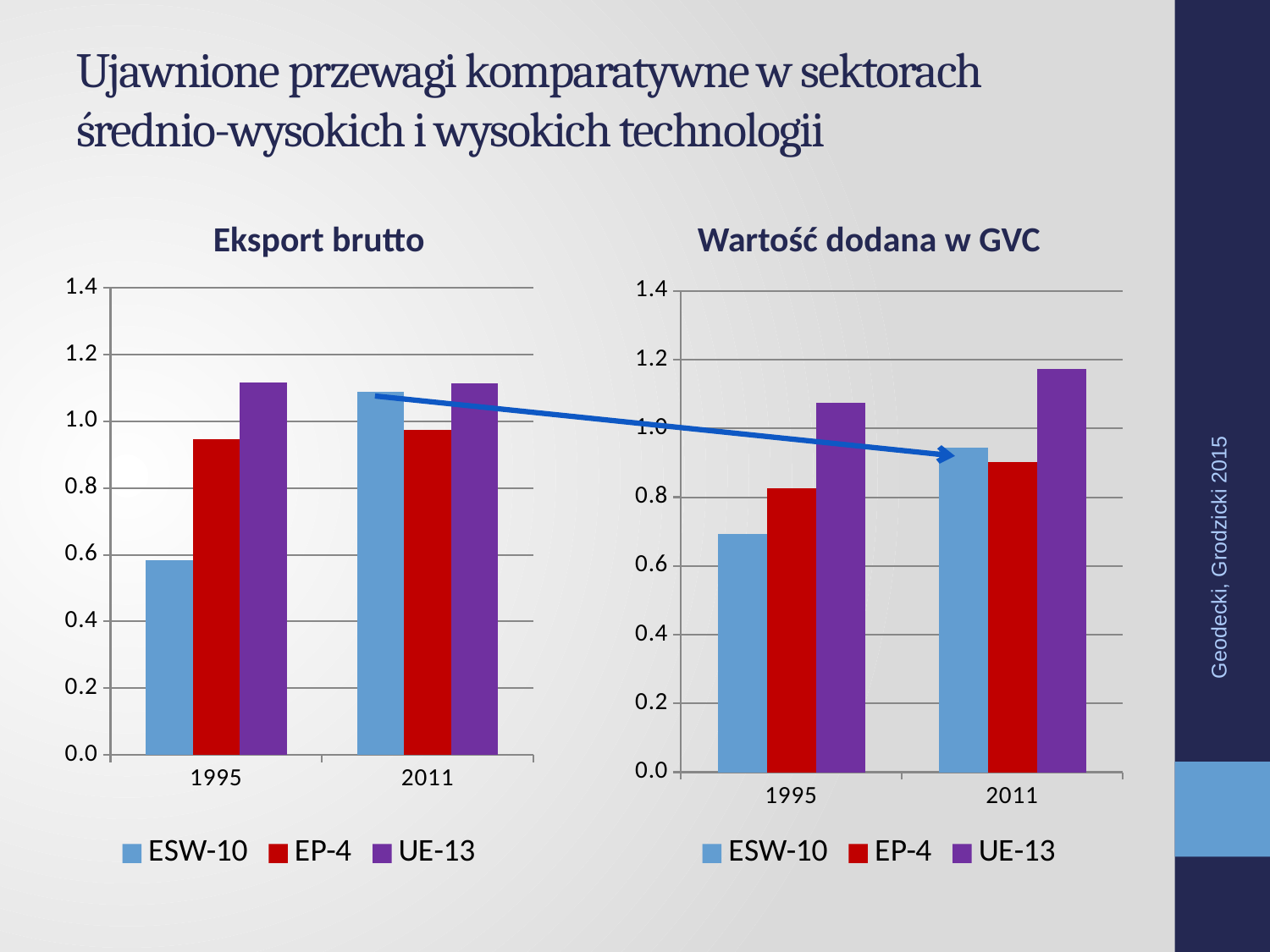
In the 'Wartość dodana w GVC' chart, is the value for ESW-10 in 1995 greater or less than 0.8? less In the 'Eksport brutto' chart, which series has the lowest value in 1995? ESW-10 How many series does the legend of the 'Wartość dodana w GVC' chart list? 3 What kind of chart is the 'Eksport brutto' chart? bar chart In the 'Eksport brutto' chart, is the value for UE-13 in 1995 greater or less than 1.0? greater In the 'Wartość dodana w GVC' chart, what colour represents the EP-4 series? red How many year categories are shown on the x axis of the 'Eksport brutto' chart? 2 In the 'Eksport brutto' chart, does the ESW-10 value rise or fall from 1995 to 2011? rise In the 'Eksport brutto' chart, is the ESW-10 value larger in 1995 or in 2011? 2011 In the 'Wartość dodana w GVC' chart, is the value for UE-13 in 2011 greater or less than 1.0? greater In the 'Wartość dodana w GVC' chart, which series has the highest value in 2011? UE-13